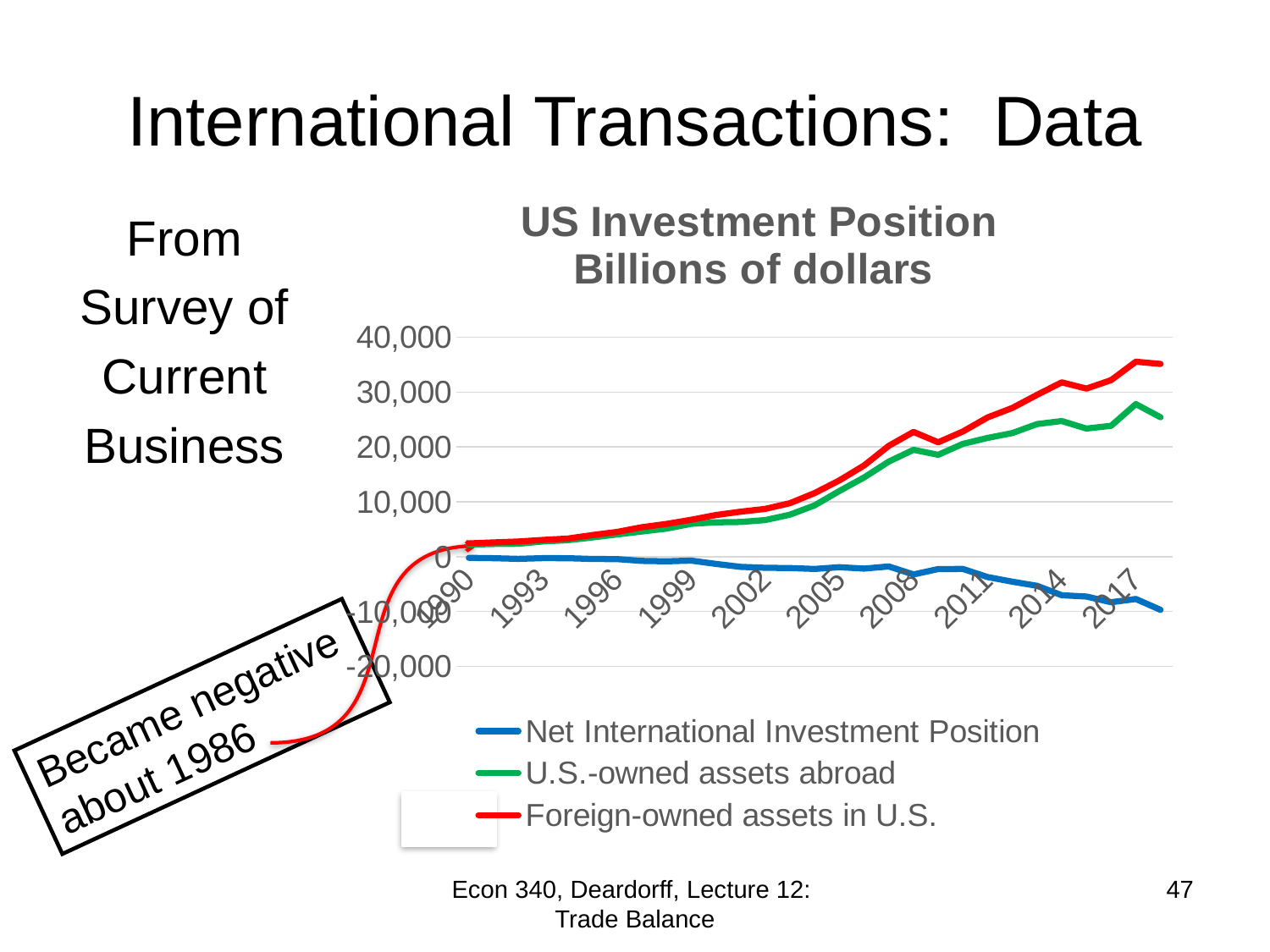
Which colour is used for the Net International Investment Position line? blue Is the value for U.S.-owned assets abroad in 2017 greater or less than 30,000? less How many series does the legend list? 3 Does the Foreign-owned assets in U.S. line generally rise or fall from 1990 to 2017? rise Is the value for Foreign-owned assets in U.S. in 2005 greater or less than 10,000? greater In 2017, which is larger: Foreign-owned assets in U.S. or U.S.-owned assets abroad? Foreign-owned assets in U.S. What kind of chart is shown on the slide? line chart Does the Net International Investment Position line generally rise or fall from 1990 to 2017? fall Which series has the lowest value in 2017? Net International Investment Position Is the value for Foreign-owned assets in U.S. in 2017 greater or less than 30,000? greater What is the title of the chart? US Investment Position Billions of dollars